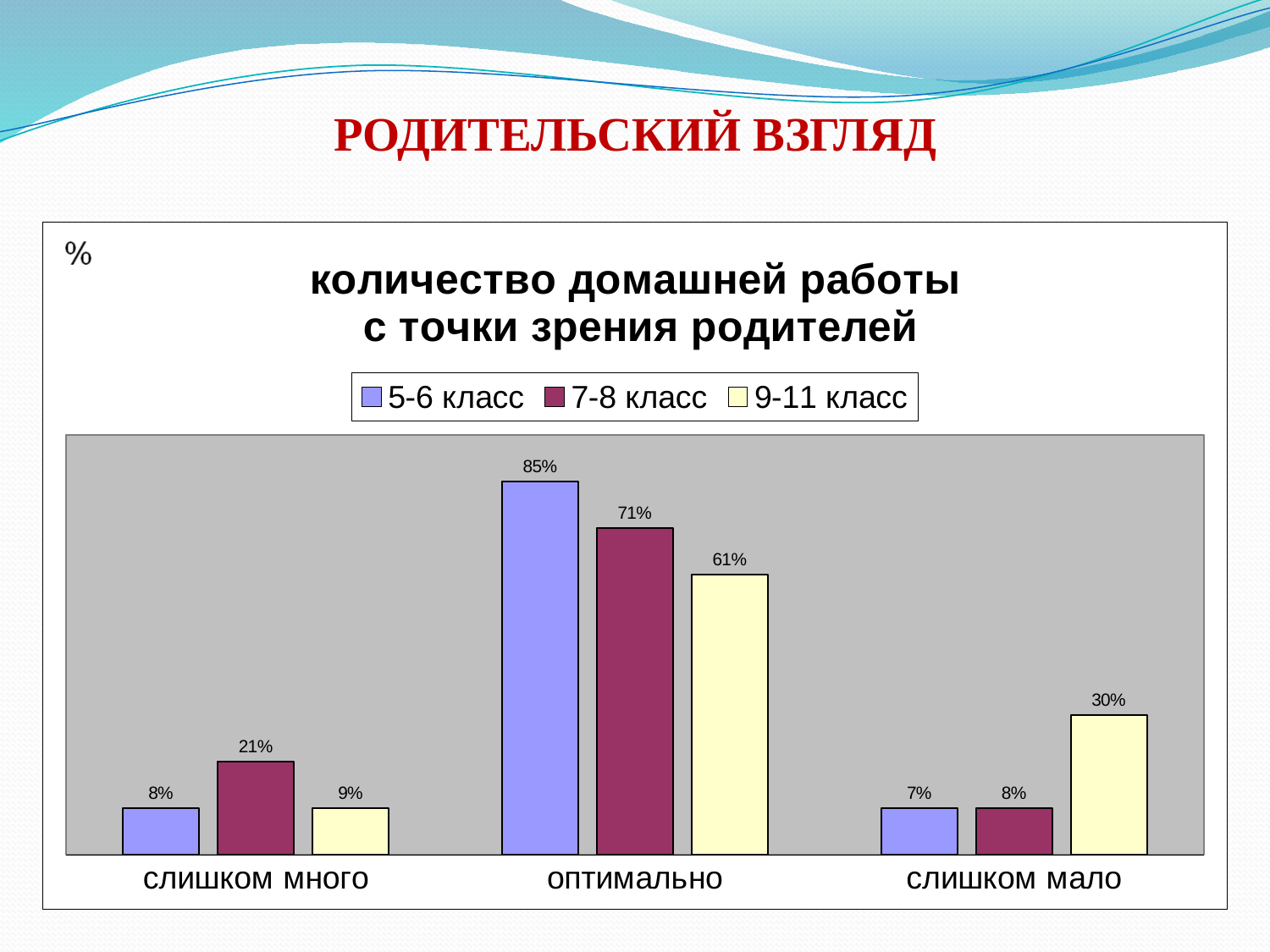
In the слишком мало category, which series has the larger value: 7-8 класс or 9-11 класс? 9-11 класс What is the value for 9-11 класс in the слишком мало category? 30% How many categories are shown on the x axis? 3 Which category has the lowest value for 5-6 класс? слишком мало What is the value for 5-6 класс in the оптимально category? 85% What is the title of the chart? количество домашней работы с точки зрения родителей Which series is shown in yellow in the legend? 9-11 класс Which category has the highest value for 9-11 класс? оптимально What is the difference between the 5-6 класс and 9-11 класс values in the оптимально category? 24% What kind of chart is shown on the slide? bar chart How many series does the legend list? 3 What is the value for 7-8 класс in the слишком много category? 21%